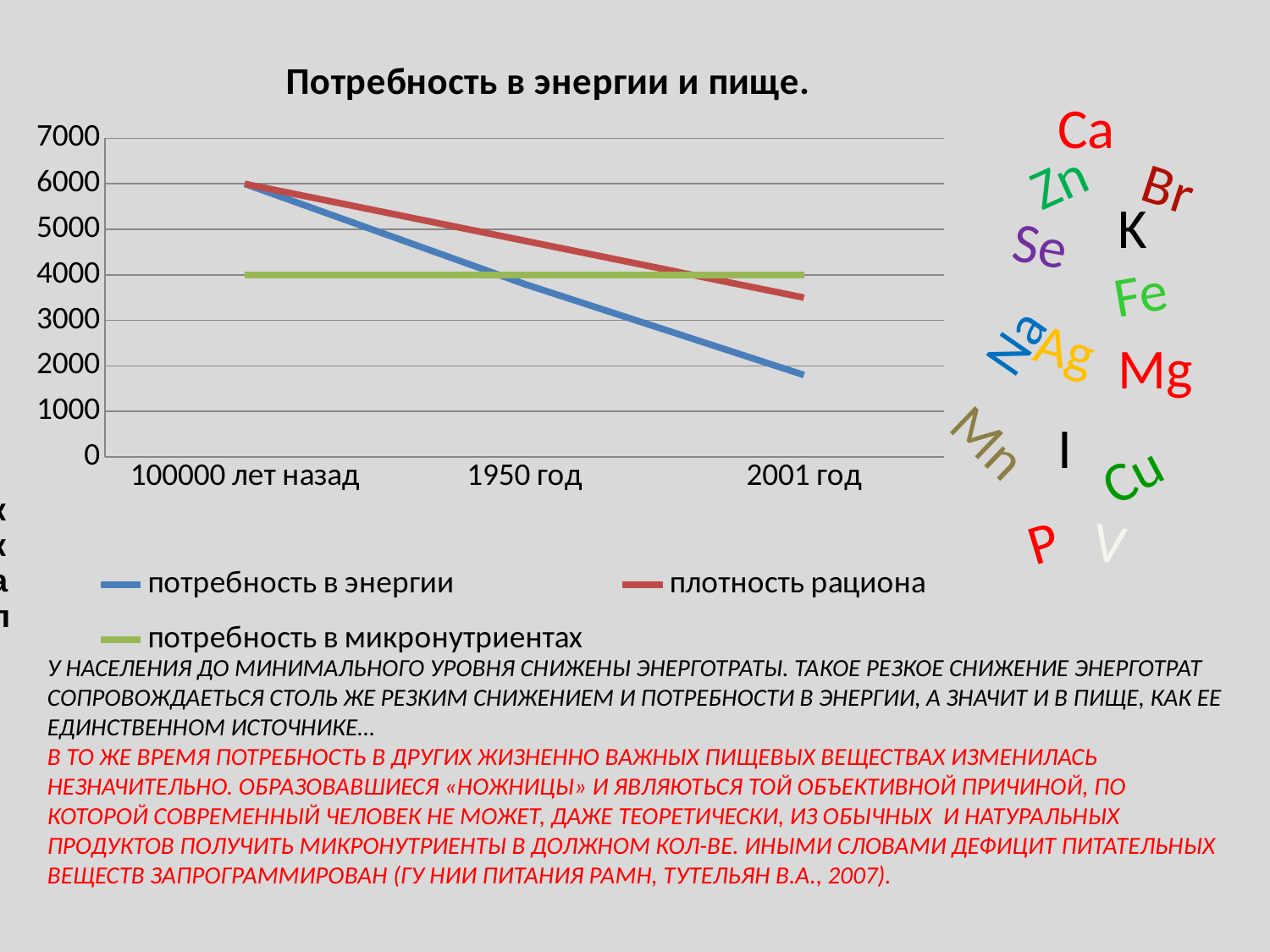
What is the value of "потребность в микронутриентах" at "1950 год"? 4000 What is the value of "плотность рациона" at "100000 лет назад"? 6000 Does the "потребность в энергии" series rise or fall from "100000 лет назад" to "2001 год"? fall Is the value of "потребность в энергии" at "2001 год" greater or less than 3000? less How many series does the legend list? 3 What kind of chart is shown on the slide? line chart How many categories are shown on the x axis? 3 Which series has the larger value at "2001 год": "потребность в энергии" or "плотность рациона"? плотность рациона What is the value of "потребность в энергии" at "100000 лет назад"? 6000 What is the title of the chart? Потребность в энергии и пище. Which colour is used for the "потребность в микронутриентах" series? green Is the value of "плотность рациона" at "2001 год" greater or less than 4000? less